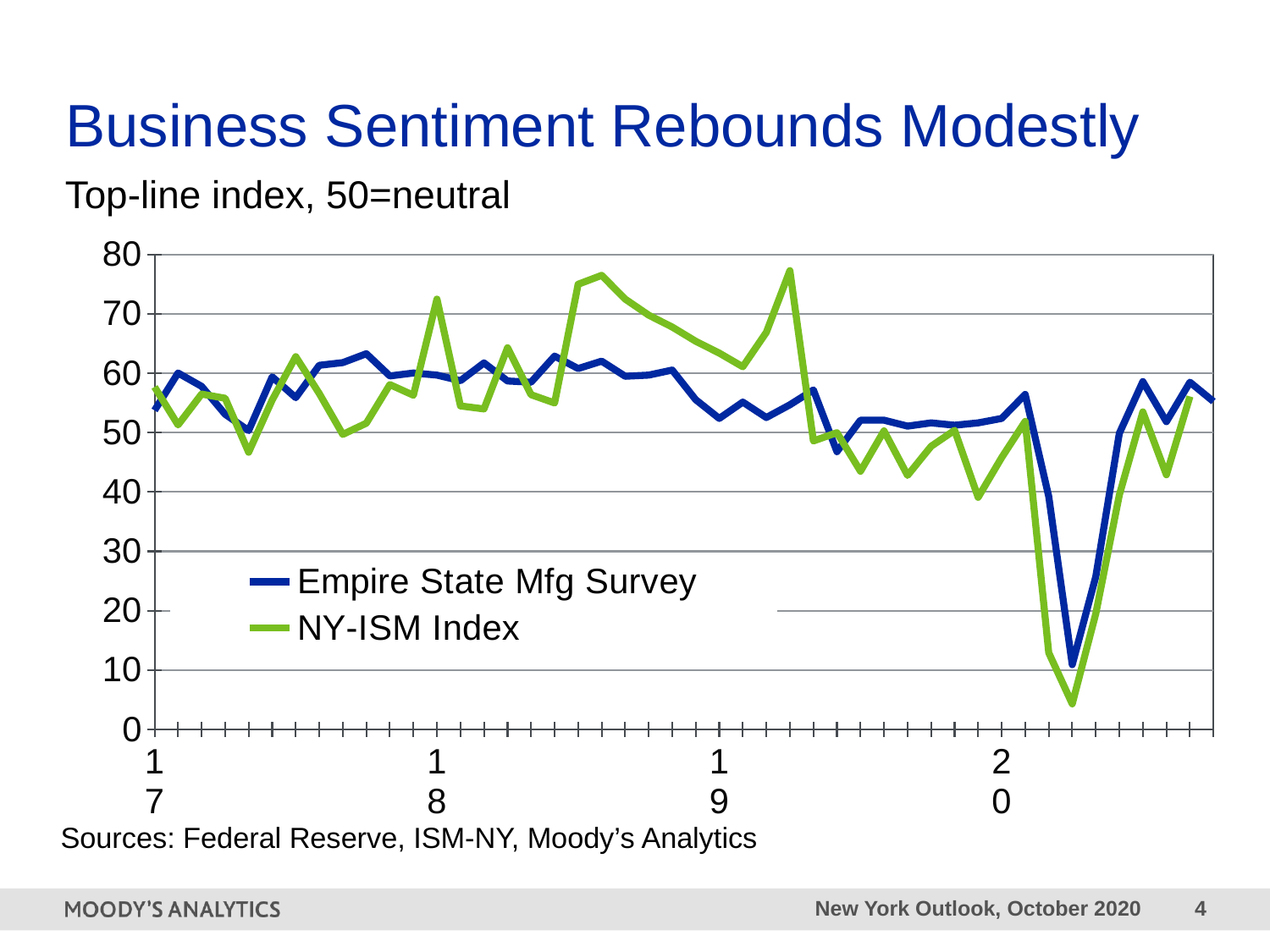
What kind of chart is shown on the slide? Line chart How many series does the legend list? 2 Is the peak value of the NY-ISM Index in 2019 greater or less than 70? greater What is the title of the chart on the slide? Business Sentiment Rebounds Modestly What are the two series named in the legend? Empire State Mfg Survey and NY-ISM Index At the trough in 2020, which series dropped lower, the Empire State Mfg Survey or the NY-ISM Index? NY-ISM Index Which series reaches the highest value anywhere on the chart? NY-ISM Index Which series falls to the lowest value anywhere on the chart? NY-ISM Index Is the lowest value of the Empire State Mfg Survey in 2020 greater or less than 20? less Is the highest value of the Empire State Mfg Survey greater or less than 70? less